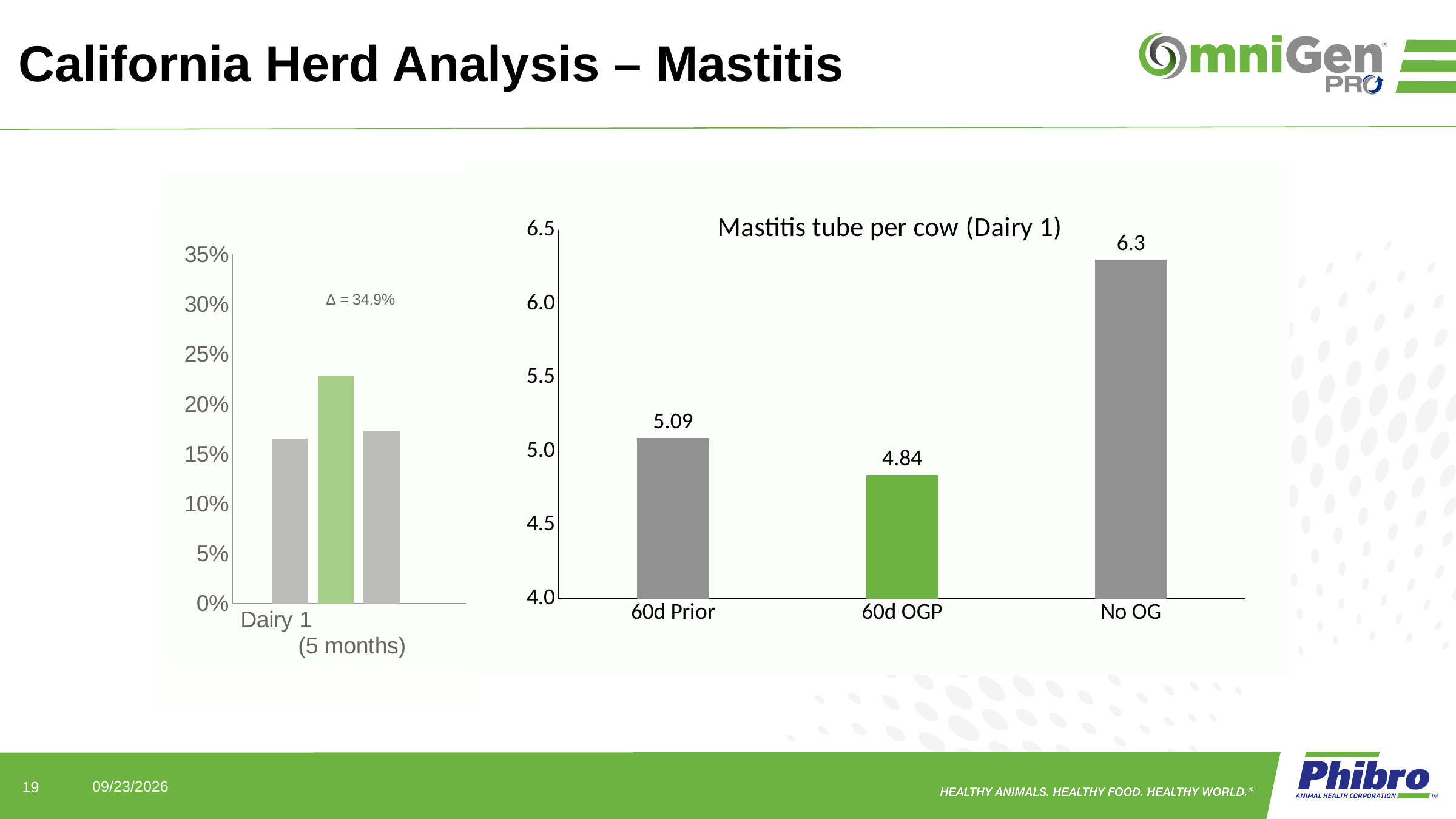
In the chart titled 'Mastitis tube per cow (Dairy 1)', how many categories are shown on the x axis? 3 In the chart titled 'Mastitis tube per cow (Dairy 1)', what is the value for No OG? 6.3 In the chart titled 'Mastitis tube per cow (Dairy 1)', what is the value for 60d OGP? 4.84 In the chart titled 'Mastitis tube per cow (Dairy 1)', what is the value for 60d Prior? 5.09 What kind of chart is the one titled 'Mastitis tube per cow (Dairy 1)'? Bar chart In the chart titled 'Mastitis tube per cow (Dairy 1)', which is larger: 60d Prior or 60d OGP? 60d Prior In the chart titled 'Mastitis tube per cow (Dairy 1)', which category's bar is coloured green? 60d OGP In the left chart labelled 'Dairy 1 (5 months)', is the value of the green bar greater or less than 20%? greater In the chart titled 'Mastitis tube per cow (Dairy 1)', what is the difference between the 60d Prior value and the 60d OGP value? 0.25 In the chart titled 'Mastitis tube per cow (Dairy 1)', which category has the lowest value? 60d OGP In the chart titled 'Mastitis tube per cow (Dairy 1)', what is the difference between the No OG value and the 60d OGP value? 1.46 In the chart titled 'Mastitis tube per cow (Dairy 1)', which category has the highest value? No OG